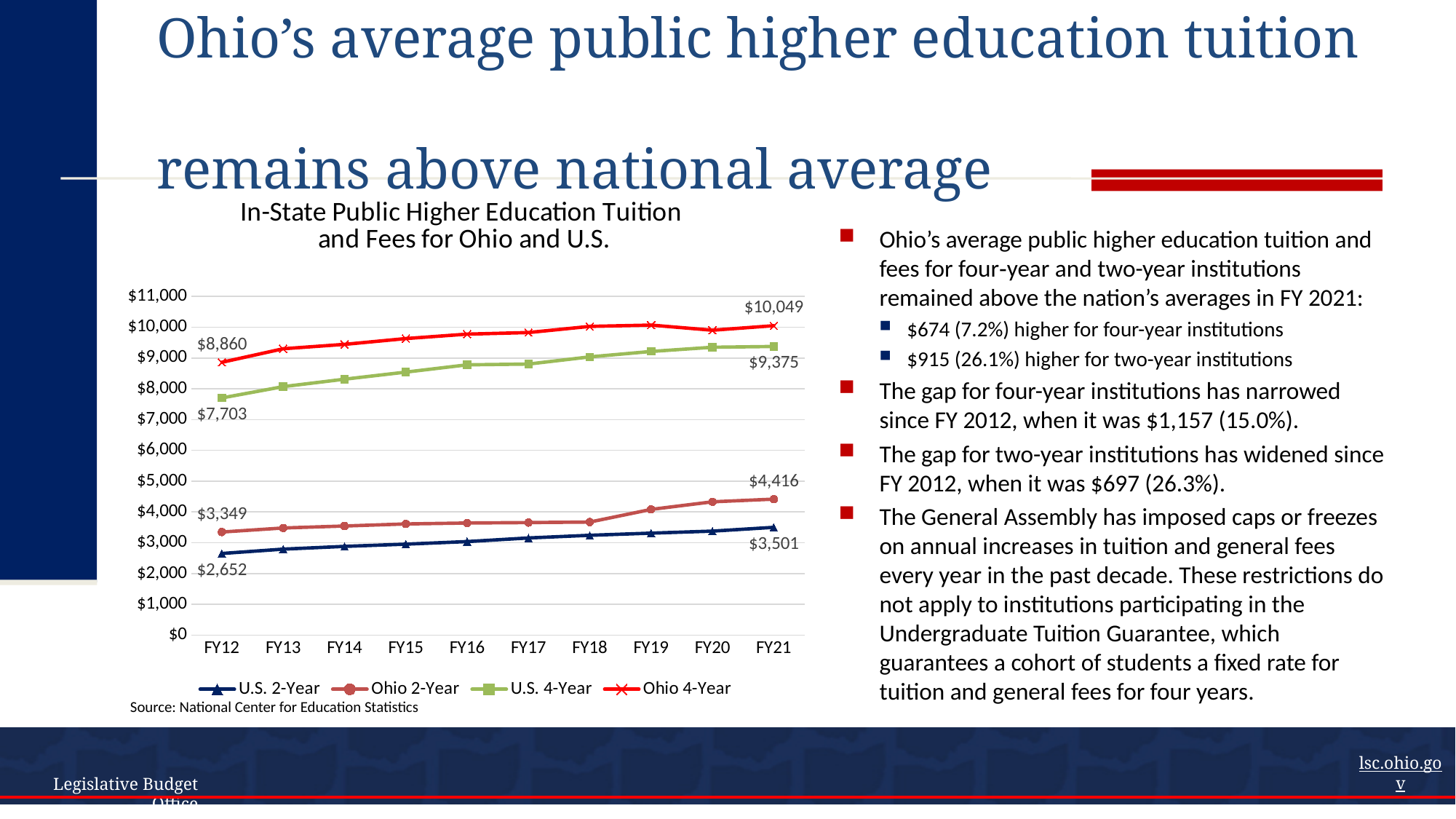
What is the Ohio 2-Year tuition and fees value for FY21? $4,416 Is the U.S. 4-Year value for FY16 greater or less than $8,000? greater What is the U.S. 4-Year tuition and fees value for FY12? $7,703 Which series has the lowest value in FY12? U.S. 2-Year How many series does the chart legend list? 4 What type of chart is shown on the slide? line chart Does the U.S. 2-Year series rise or fall from FY12 to FY21? rise What is the U.S. 2-Year tuition and fees value for FY12? $2,652 How many fiscal years are plotted along the x axis of the chart? 10 What is the difference between the Ohio 4-Year and U.S. 4-Year values in FY12? $1,157 What is the Ohio 4-Year tuition and fees value for FY21? $10,049 Which series has the highest value in FY21? Ohio 4-Year